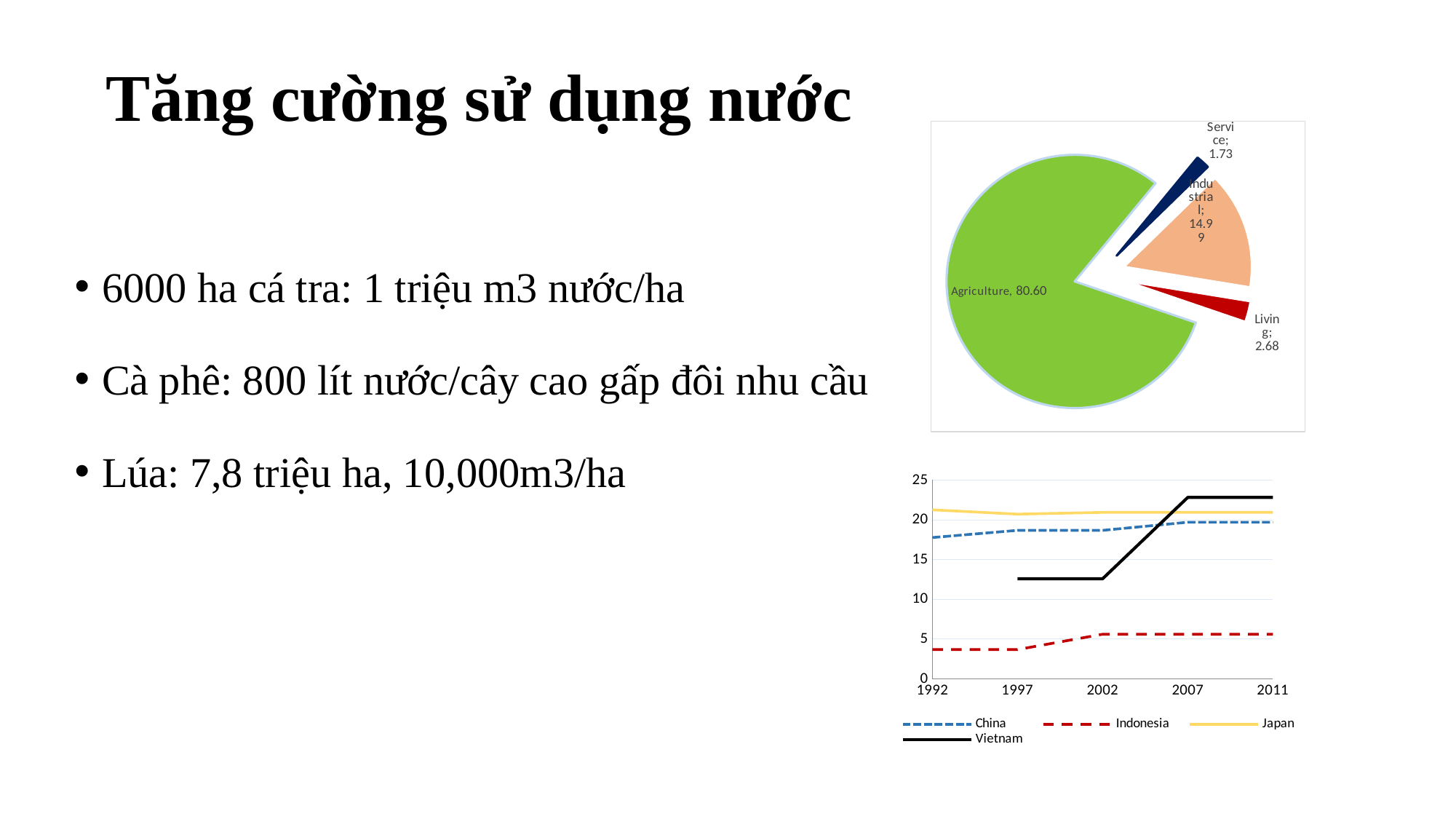
In the pie chart at the top right, which category has the smallest slice? Service In the pie chart at the top right, what is the value for Living? 2.68 In the line chart at the bottom right, is the value for Vietnam in 2011 greater or less than 20? greater In the pie chart at the top right, what is the value for Industrial? 14.99 In the pie chart at the top right, how many slices are there? 4 In the pie chart at the top right, which category has the largest slice? Agriculture In the line chart at the bottom right, which series has the lowest values across all years? Indonesia How many series does the legend of the line chart at the bottom right list? 4 In the pie chart at the top right, what is the value for Agriculture? 80.60 In the pie chart at the top right, what is the value for Service? 1.73 What kind of chart is the chart at the bottom right? line chart In the pie chart at the top right, what is the difference between the Industrial and Living values? 12.31